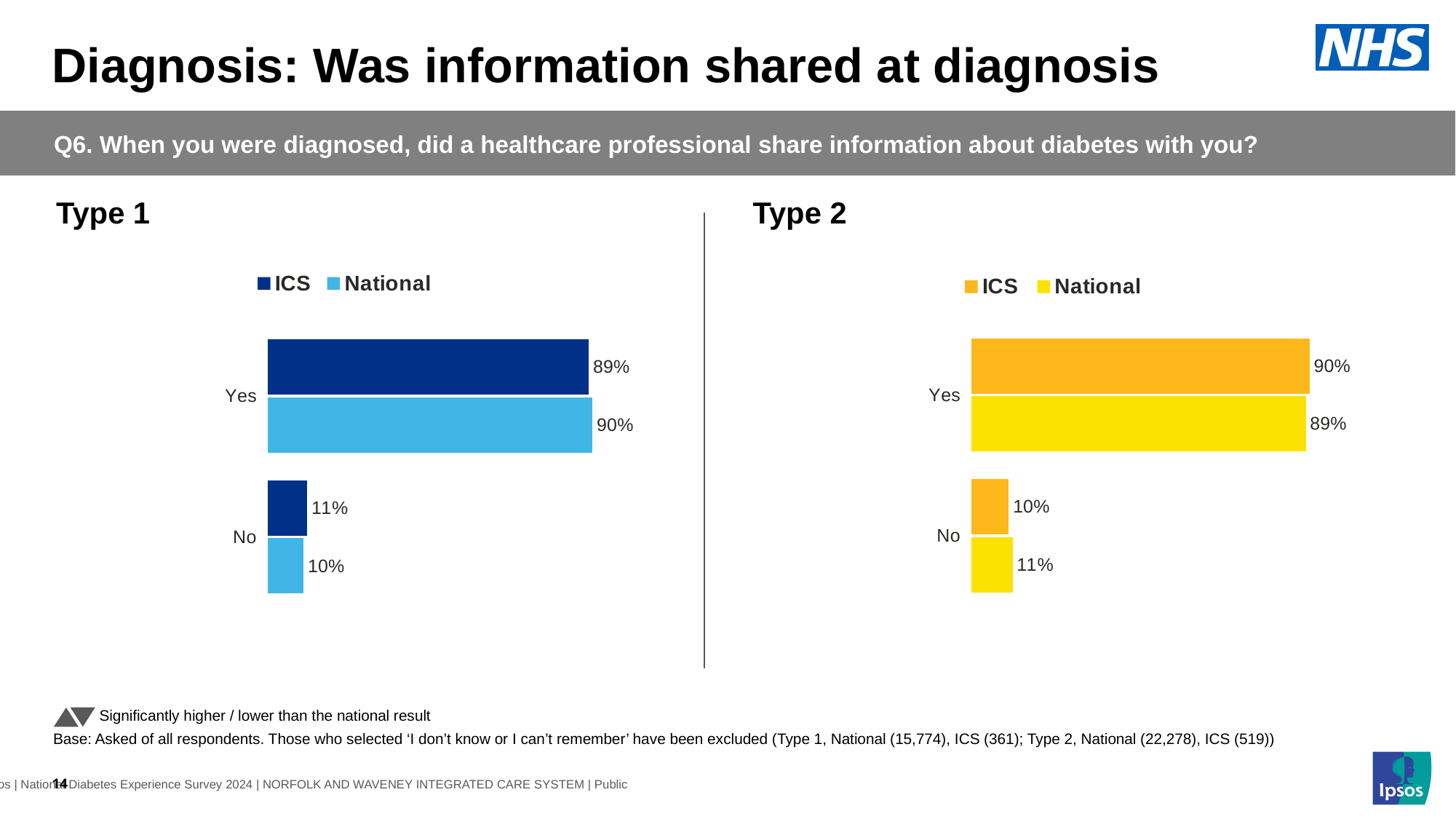
In the Type 2 chart, which category has the lowest National value? No What kind of chart is the Type 1 chart? Bar chart How many categories are shown in the Type 1 chart? 2 In the Type 1 chart, what is the ICS value for Yes? 89% In the Type 2 chart, what is the ICS value for Yes? 90% In the Type 2 chart, what is the National value for No? 11% What are the two series named in the legend of the Type 1 chart? ICS and National In the Type 1 chart, which category has the highest ICS value? Yes In the Type 1 chart, what is the difference between the National and ICS values for Yes? 1% In the Type 1 chart, what is the National value for No? 10% How many series does the legend of the Type 2 chart list? 2 In the Type 2 chart, which is larger for Yes: the ICS value or the National value? ICS